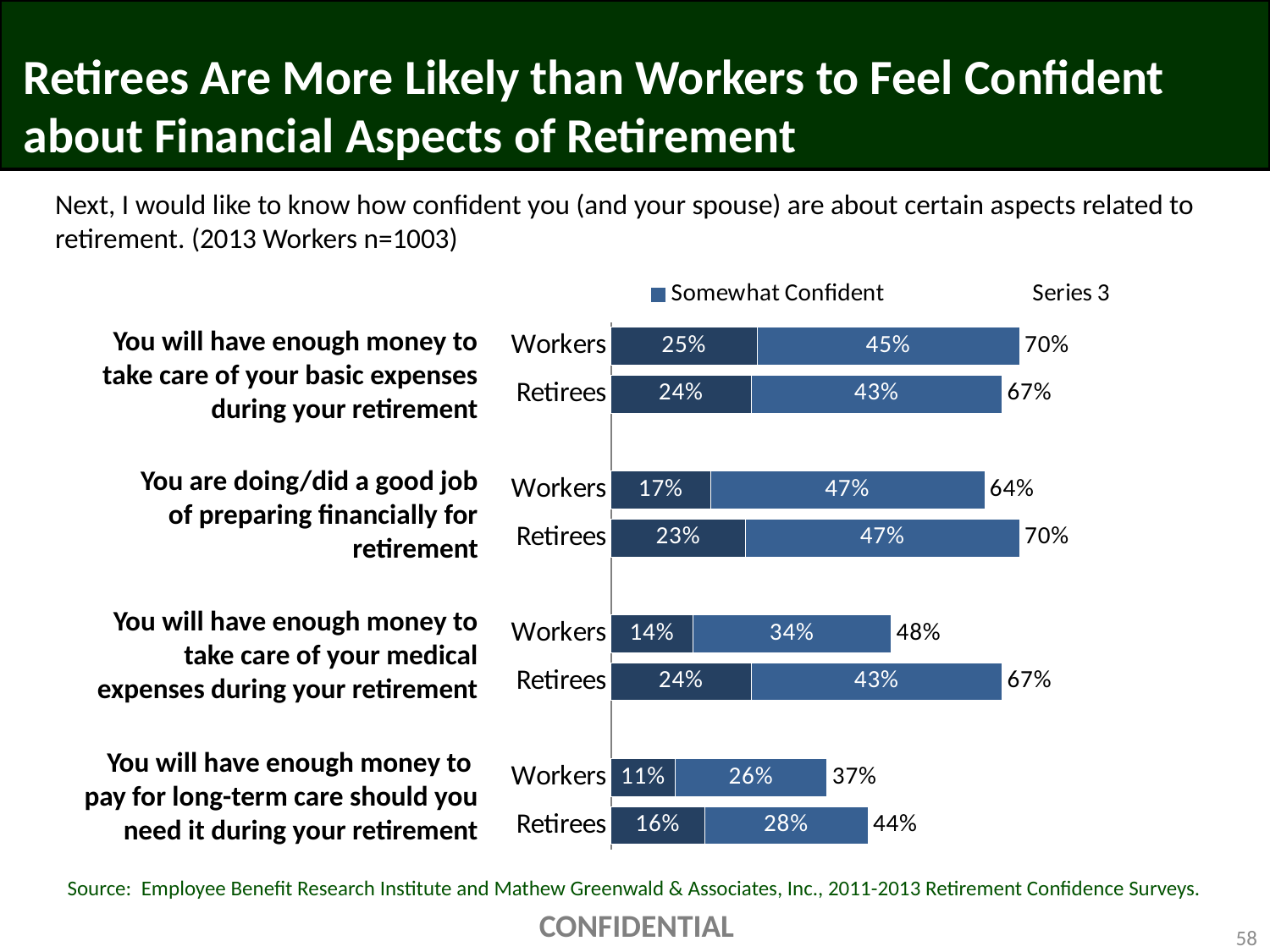
How many bars are plotted on the chart? 8 How many percentage points higher is the Retirees total than the Workers total for having enough money for medical expenses? 19 percentage points What is the Somewhat Confident value for Workers on having enough money for basic expenses during retirement? 45% What is the total of the stacked bar for Workers on doing a good job of preparing financially for retirement? 64% What is the total percentage shown for Retirees on having enough money for medical expenses during retirement? 67% What is the value of the dark blue segment for Retirees on doing a good job of preparing financially for retirement? 23% Which legend entry is shown with a coloured marker? Somewhat Confident For having enough money for basic expenses, which group has the larger total percentage, Workers or Retirees? Workers What is the value of the dark blue segment for Workers on having enough money to pay for long-term care? 11% What kind of chart is shown on the slide? Stacked bar chart Which bar has the lowest total percentage on the chart? Workers, enough money to pay for long-term care (37%) What is the difference between the Somewhat Confident values for Retirees and Workers on paying for long-term care? 2 percentage points